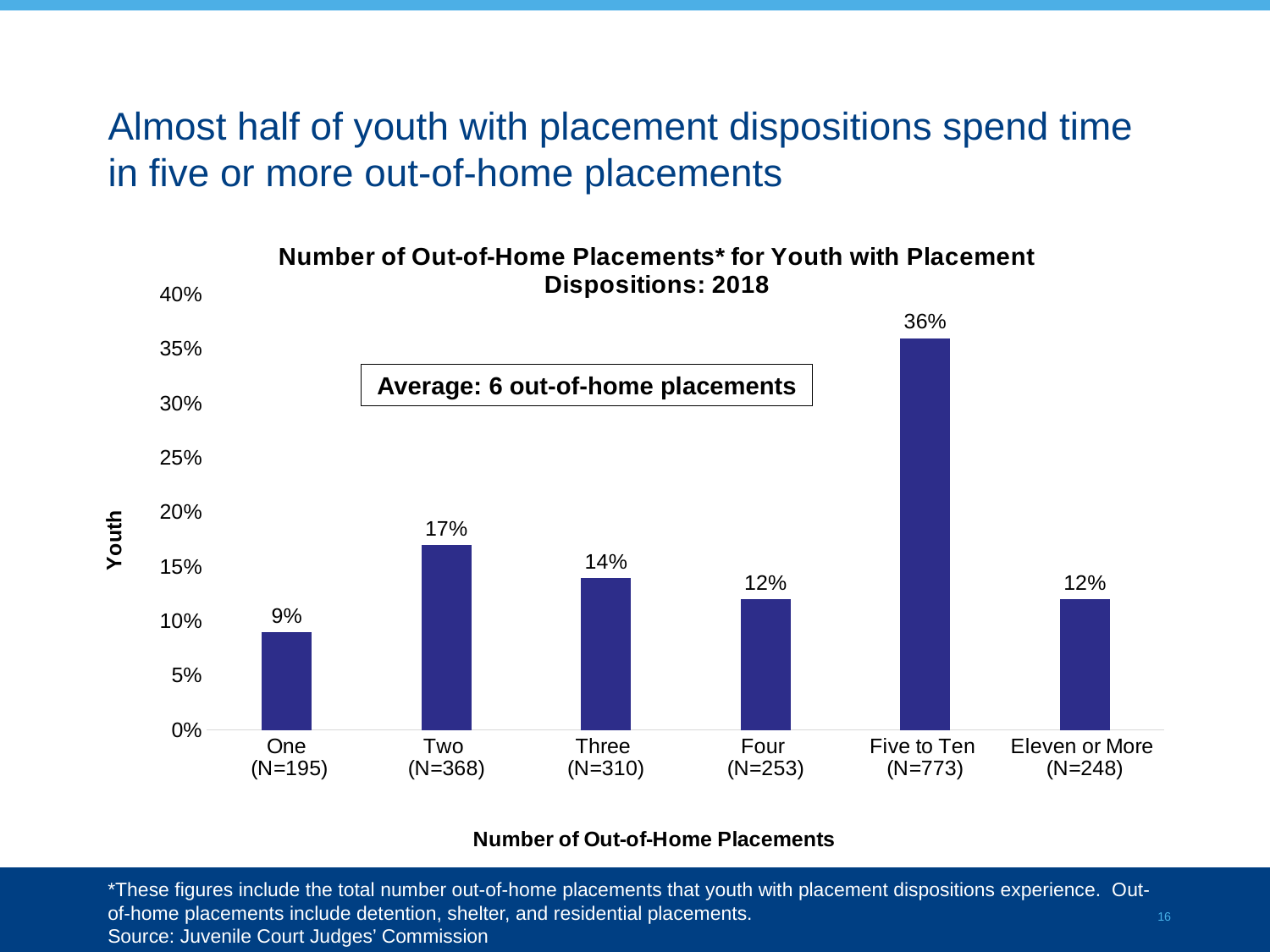
Which category of number of out-of-home placements has the highest percentage of youth? Five to Ten Which category of number of out-of-home placements has the lowest percentage of youth? One What average number of out-of-home placements is stated in the box on the chart? 6 out-of-home placements What kind of chart is shown on the slide? Bar chart What is the difference in percentage points between youth with two placements and youth with one placement? 8 percentage points Which is larger: the percentage of youth with two placements or the percentage with three placements? Two What is the title of the chart? Number of Out-of-Home Placements* for Youth with Placement Dispositions: 2018 What percentage of youth had one out-of-home placement? 9% What percentage of youth had three out-of-home placements? 14% What percentage of youth had five to ten out-of-home placements? 36% What is the sample size (N) for the Five to Ten category? 773 How many categories of number of out-of-home placements are shown on the x axis? 6